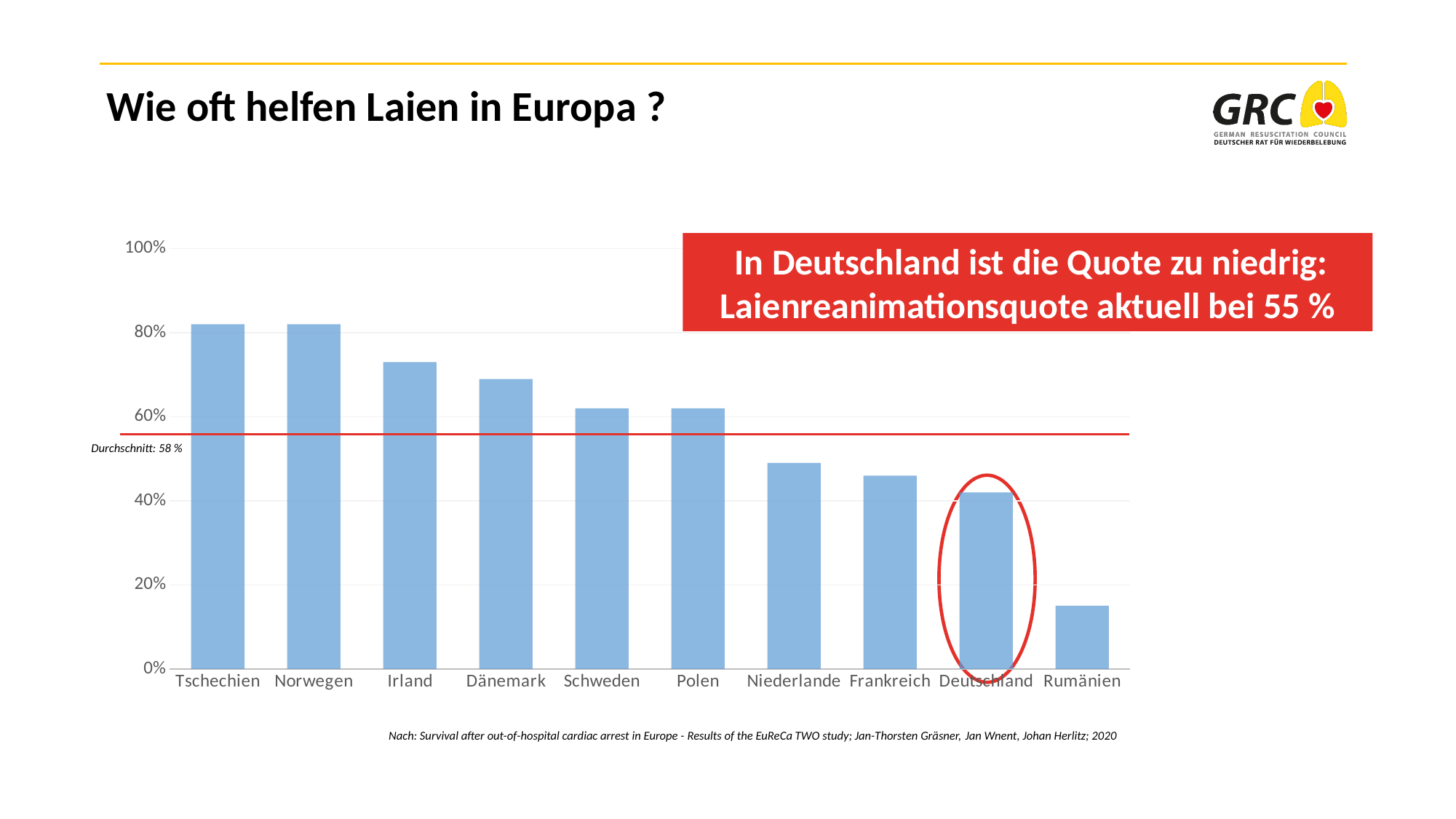
Which country has the lowest bar in the chart? Rumänien Is the value for Niederlande greater or less than 60%? less What kind of chart is shown on the slide? bar chart Is the value for Tschechien greater or less than 80%? greater Is the value for Irland greater or less than 60%? greater How many countries are shown on the x axis of the chart? 10 What average value is marked by the horizontal red line in the chart? 58 % Which has the larger value, Frankreich or Rumänien? Frankreich Which has the larger value, Irland or Niederlande? Irland Do the bar values generally rise or fall from left to right along the x axis? fall